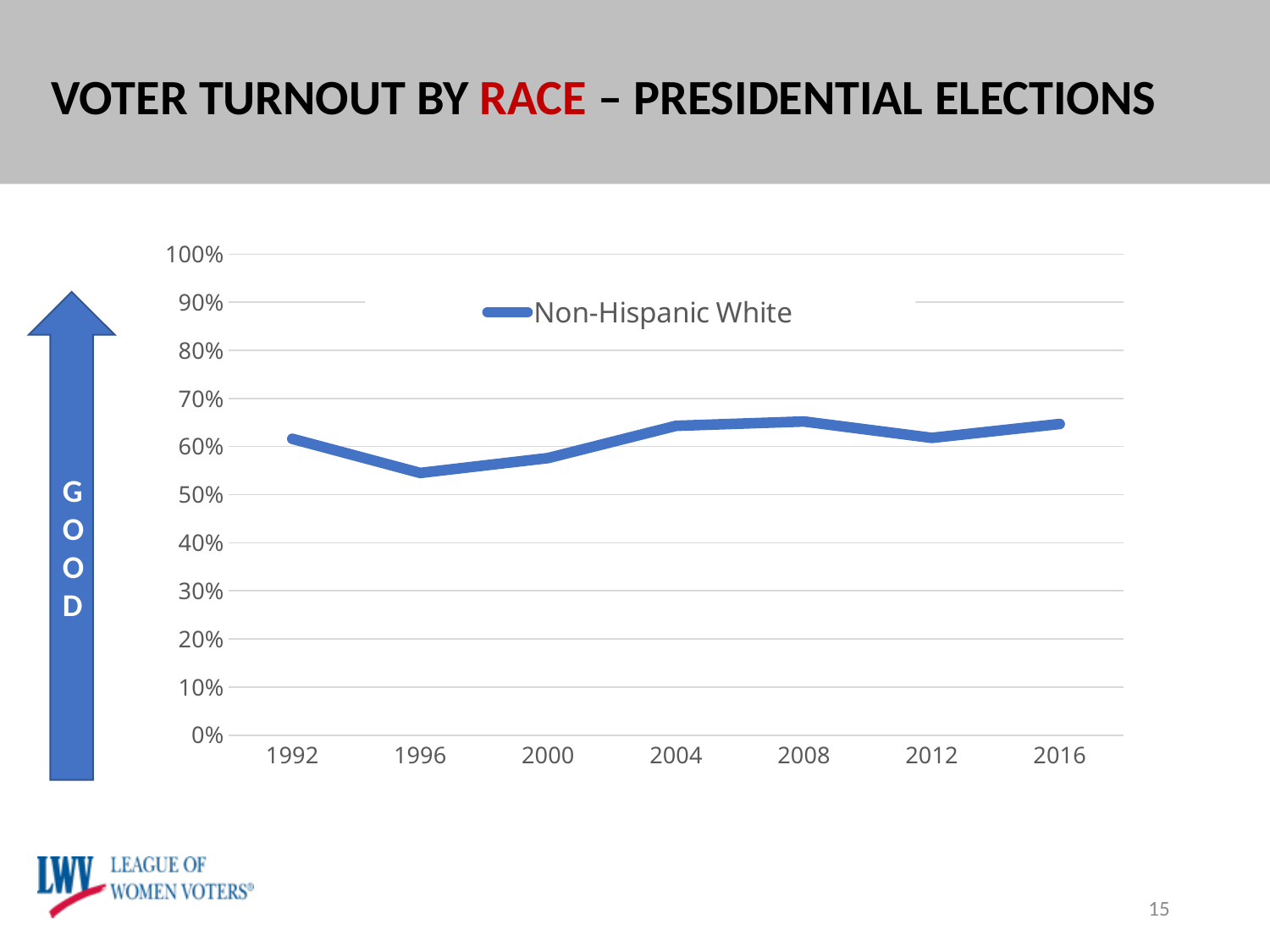
Which year has the higher turnout, 2000 or 2004? 2004 Is the value for 2004 greater or less than 70%? less Which year has the higher turnout, 1992 or 1996? 1992 Is the value for 2008 greater or less than 60%? greater What series name appears in the legend? Non-Hispanic White How many election years are plotted on the x axis? 7 Is the value for 1992 greater or less than 50%? greater Does the turnout rise or fall from 1996 to 2008? rise How many series does the legend list? 1 Which election year has the lowest Non-Hispanic White turnout? 1996 What kind of chart is shown on the slide? Line chart